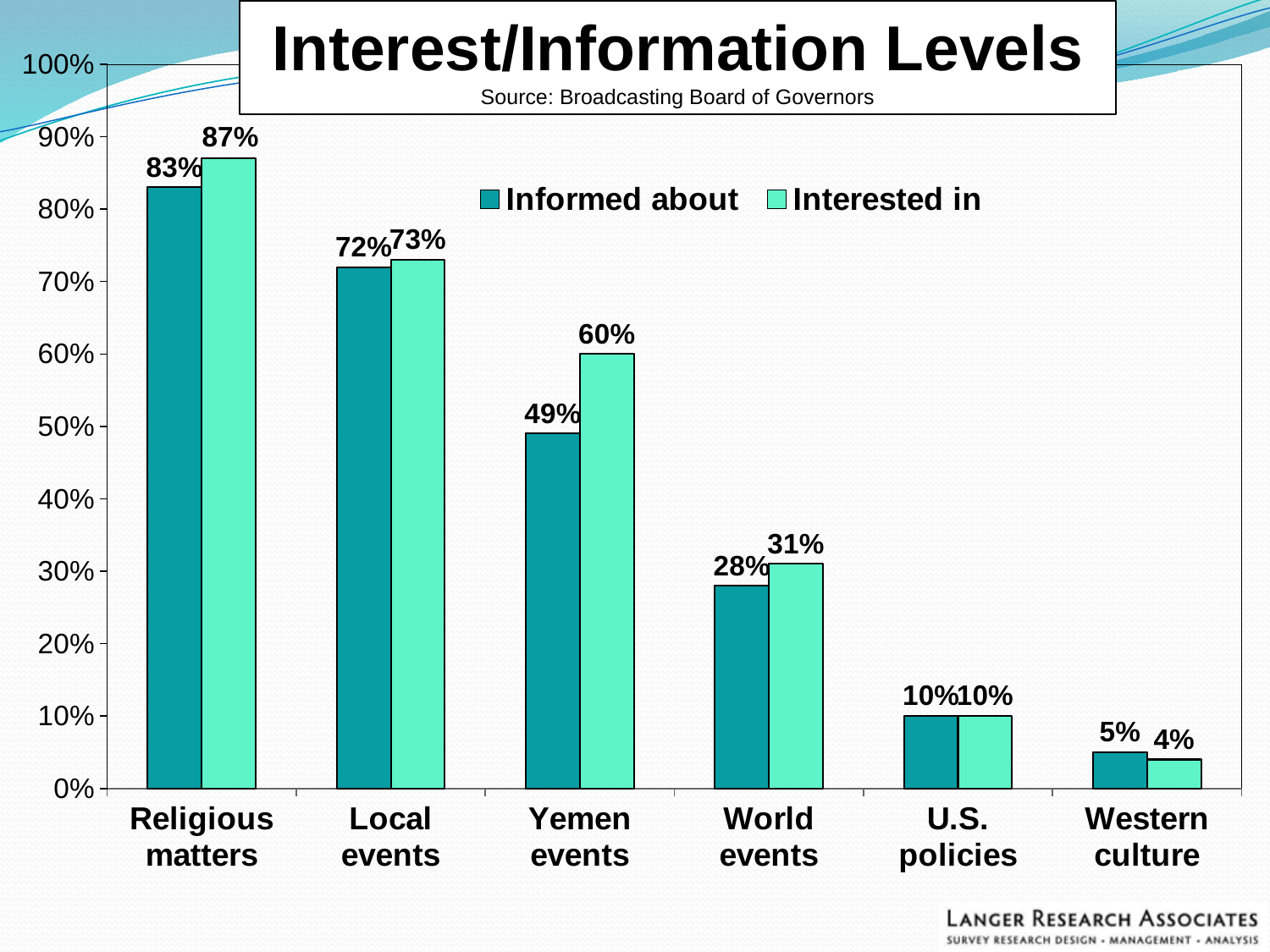
Which category has the lowest 'Informed about' value? Western culture What is the difference between the 'Interested in' and 'Informed about' values for Yemen events? 11% Do the 'Informed about' values rise or fall from left to right along the x axis? Fall What kind of chart is shown on the slide? Bar chart What is the 'Interested in' value for Yemen events? 60% What is the source cited under the chart title? Broadcasting Board of Governors What is the 'Informed about' value for World events? 28% How many series does the legend list? 2 What is the 'Informed about' value for Religious matters? 83% How many categories are shown on the x axis? 6 Which is larger for Western culture: 'Informed about' or 'Interested in'? Informed about Which category has the highest 'Interested in' value? Religious matters